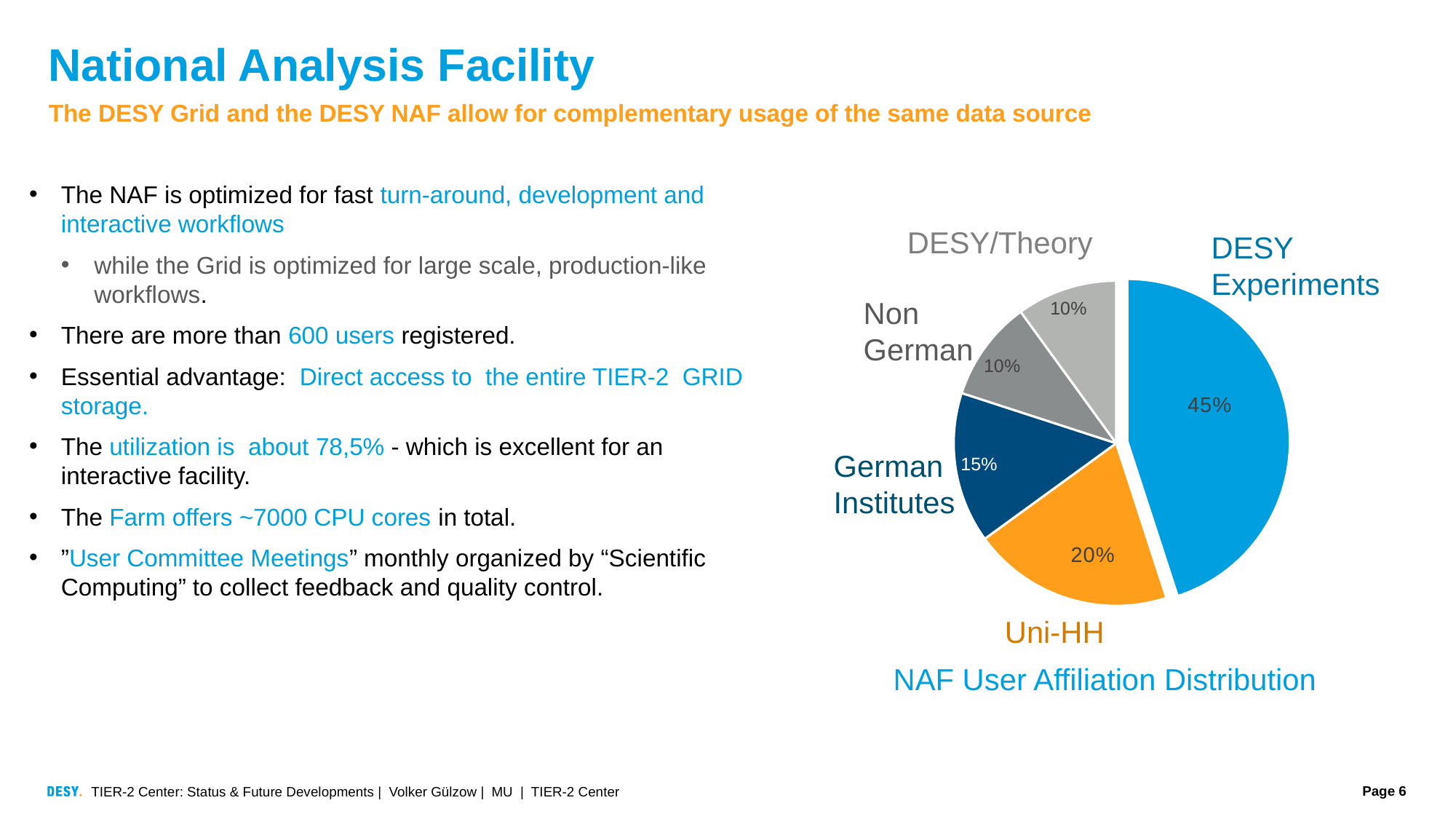
What is the combined share of Non German and DESY/Theory users? 20% What is the title of the chart? NAF User Affiliation Distribution What share of NAF users is affiliated with Uni-HH? 20% What colour is the Uni-HH slice of the pie chart? Orange What is the difference in share between DESY Experiments and Uni-HH? 25% What share of NAF users is affiliated with German Institutes? 15% Which has a larger share of NAF users, German Institutes or Uni-HH? Uni-HH Which affiliation has the largest share of NAF users? DESY Experiments What share of NAF users is affiliated with DESY/Theory? 10% How many affiliation categories are shown in the pie chart? 5 What kind of chart is shown on the slide? Pie chart What share of NAF users is affiliated with DESY Experiments? 45%